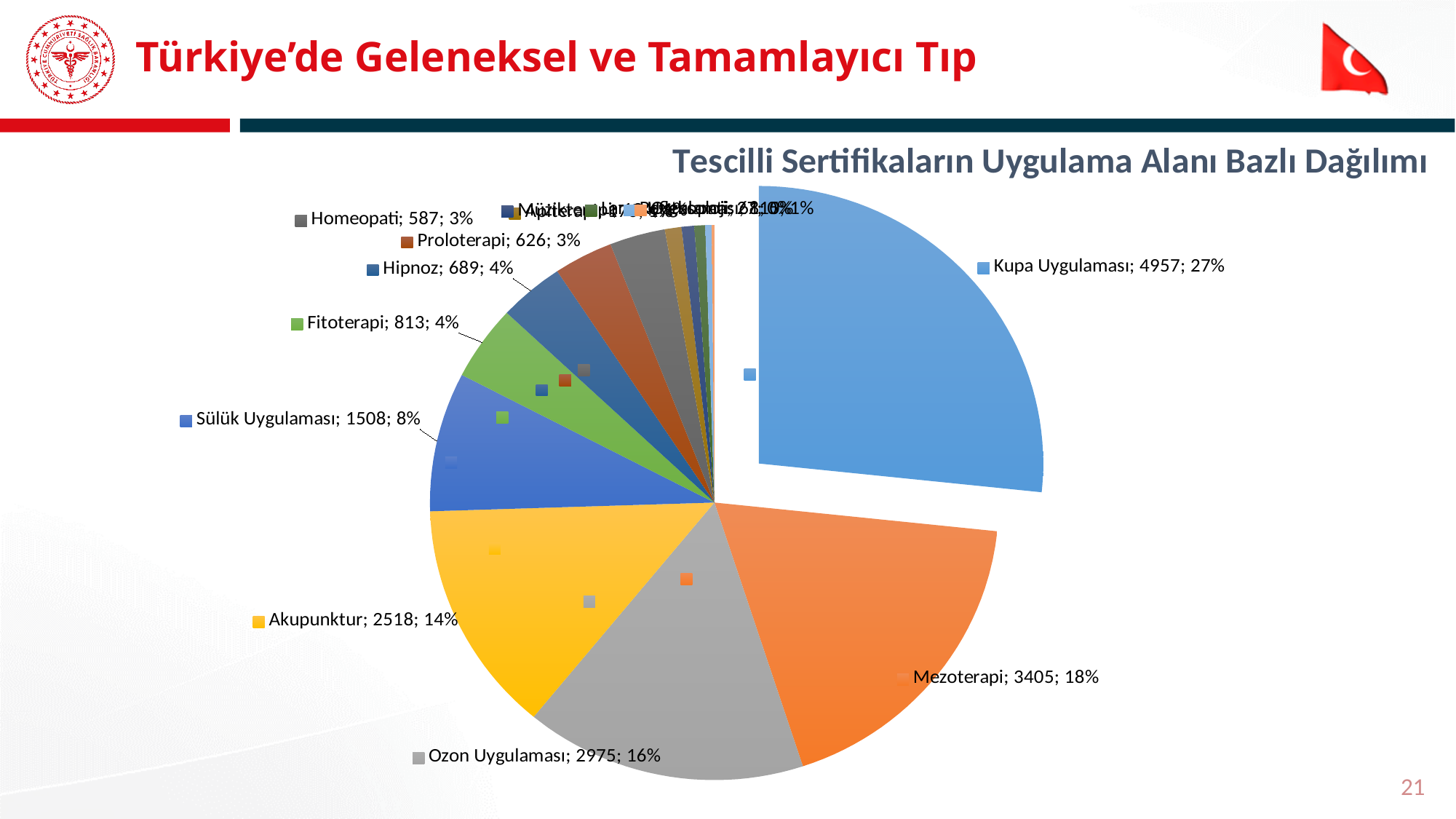
What is the title of the chart? Tescilli Sertifikaların Uygulama Alanı Bazlı Dağılımı What is the value for Mezoterapi? 3405 What is the value for Akupunktur? 2518 Which category has the largest slice of the pie? Kupa Uygulaması What is the value for Sülük Uygulaması? 1508 What share of the pie does Akupunktur represent? 14% What is the value for Kupa Uygulaması? 4957 What is the difference between the values for Kupa Uygulaması and Mezoterapi? 1552 What share of the pie does Kupa Uygulaması represent? 27% Which is larger, Mezoterapi or Ozon Uygulaması? Mezoterapi What is the value for Ozon Uygulaması? 2975 What kind of chart is shown on the slide? pie chart